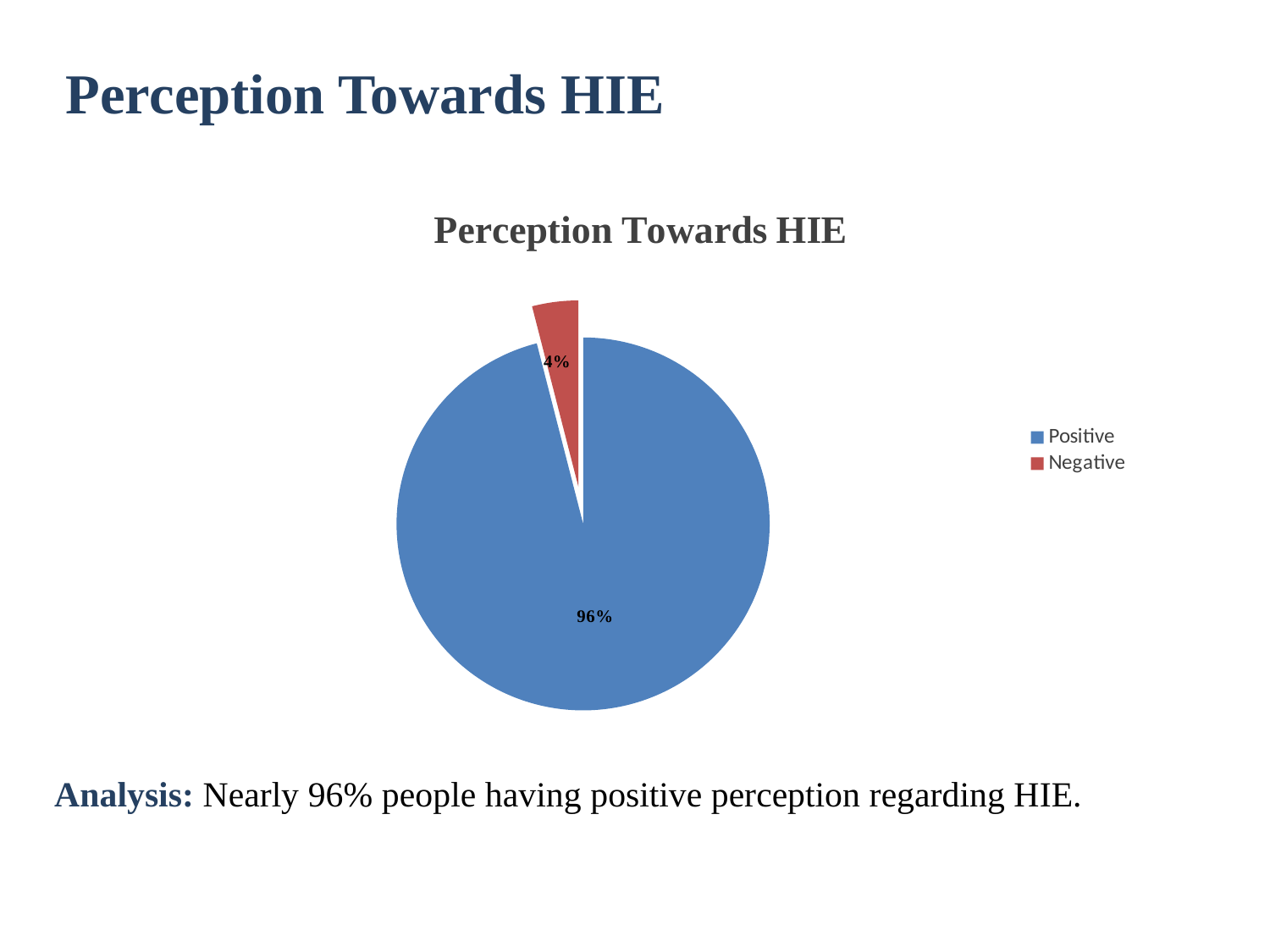
What is the title of the chart? Perception Towards HIE Which slice of the pie is the smallest? Negative How many slices does the pie chart have? 2 Which is larger, the Positive share or the Negative share? Positive Which slice of the pie is the largest? Positive What colour is the Negative slice? red What type of chart is shown on the slide? pie chart What share of the pie is Positive? 96% How many entries does the legend list? 2 What is the difference between the Positive and Negative shares? 92% What share of the pie is Negative? 4%